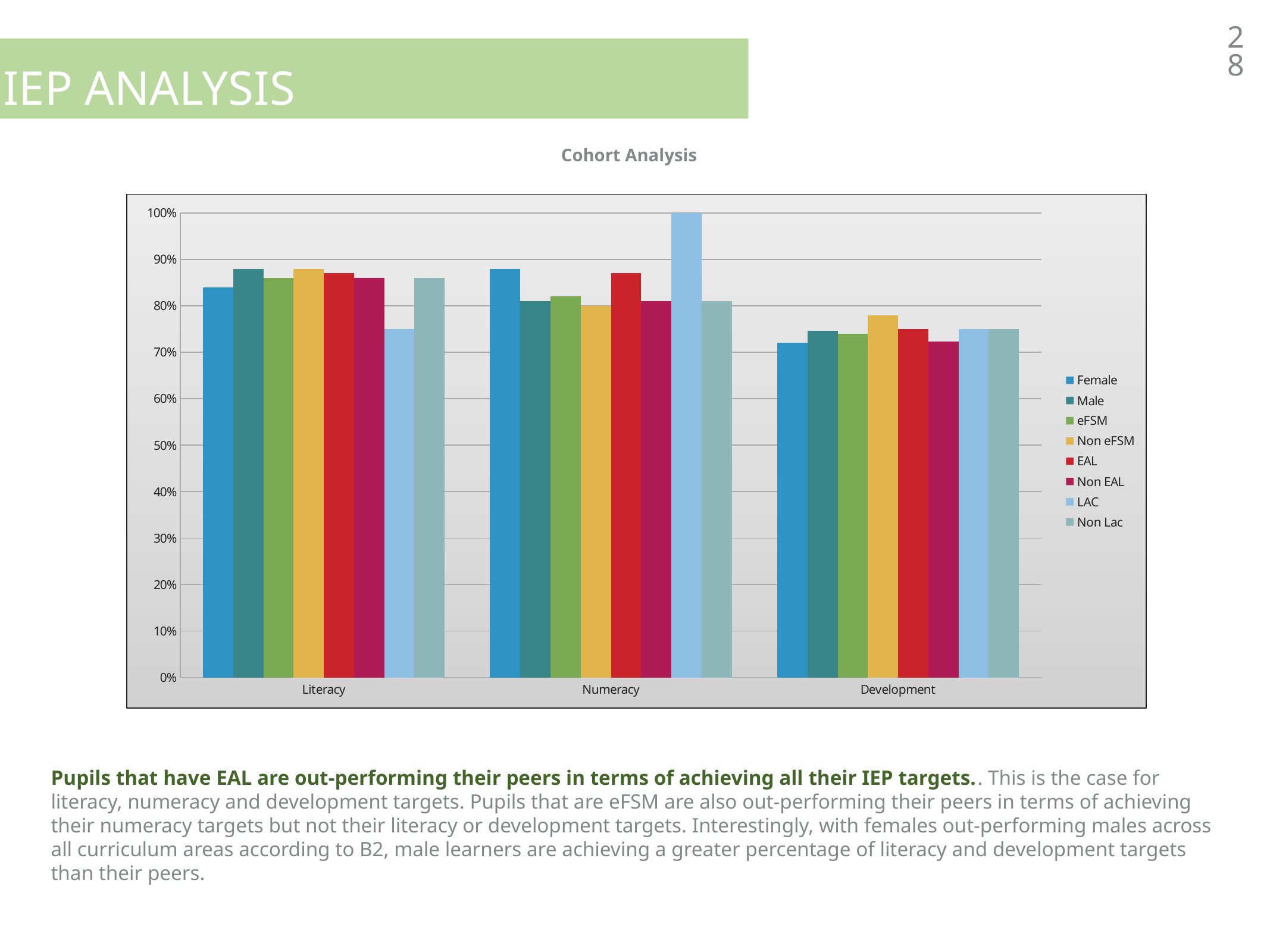
Which series has the lowest value in the Literacy category? LAC In the Numeracy category, which is larger: EAL or Non EAL? EAL What type of chart is shown on the slide? bar chart In the Literacy category, which is larger: Female or Male? Male How many categories are shown on the x axis of the Cohort Analysis chart? 3 What is the title of the chart? Cohort Analysis Is the value for Female in the Development category greater or less than 80%? less Is the value for Female in the Numeracy category greater or less than 80%? greater Is the value for LAC in the Literacy category greater or less than 80%? less Which series has the highest value in the Numeracy category? LAC How many series does the legend of the Cohort Analysis chart list? 8 What is the value for LAC in the Numeracy category? 100%